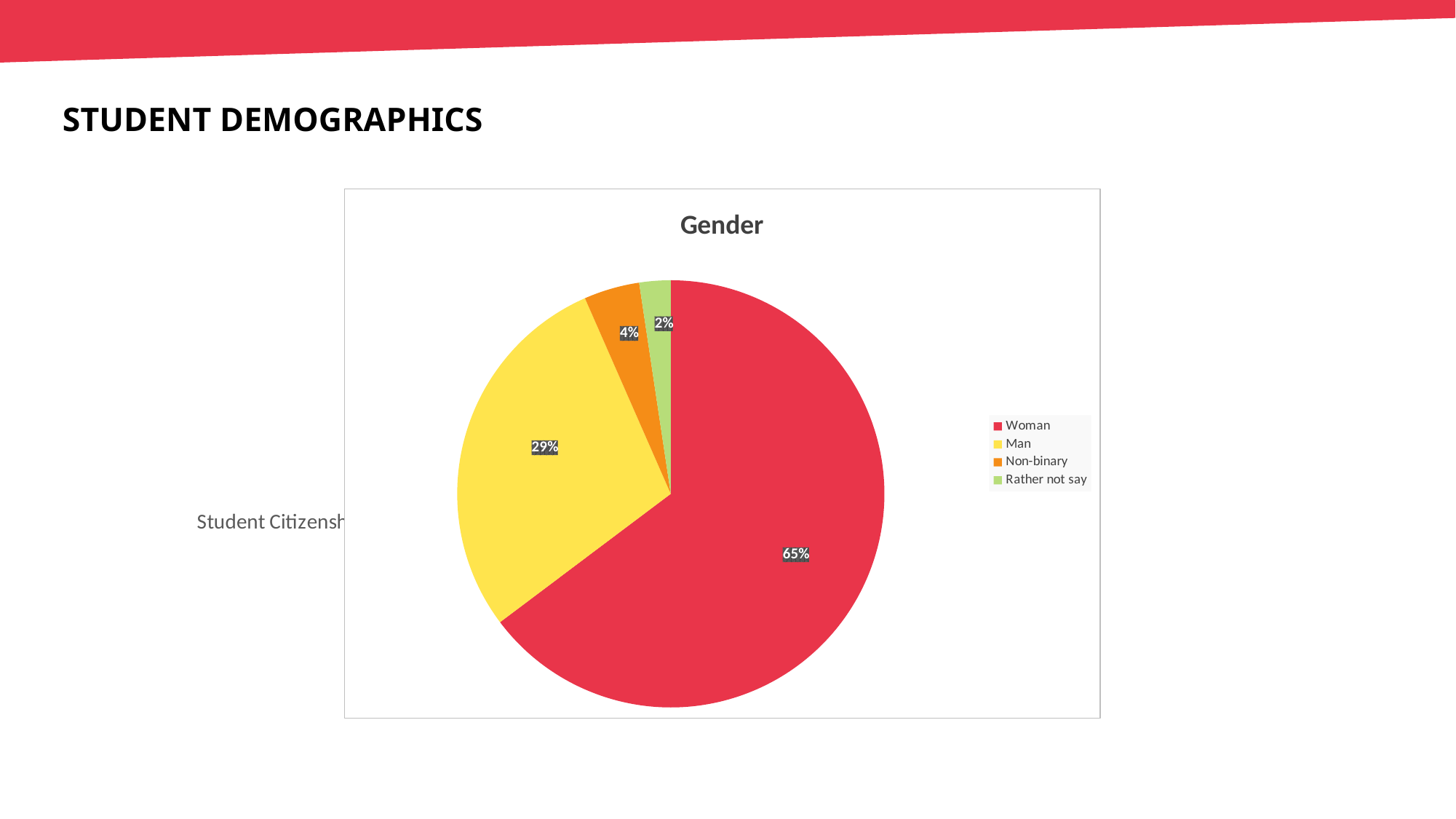
What is the title of the chart on the slide? Gender Which category has the smallest share in the Gender pie chart? Rather not say In the Gender pie chart, which is larger: Non-binary or Rather not say? Non-binary What is the difference in percentage points between Woman and Man in the Gender pie chart? 36 What type of chart is used to show Gender? Pie chart What percentage of the Gender pie chart is Non-binary? 4% What colour represents Man in the Gender pie chart? Yellow What percentage of the Gender pie chart is Rather not say? 2% What percentage of the Gender pie chart is Man? 29% Which category has the largest share in the Gender pie chart? Woman How many categories does the Gender pie chart show? 4 What percentage of the Gender pie chart is Woman? 65%